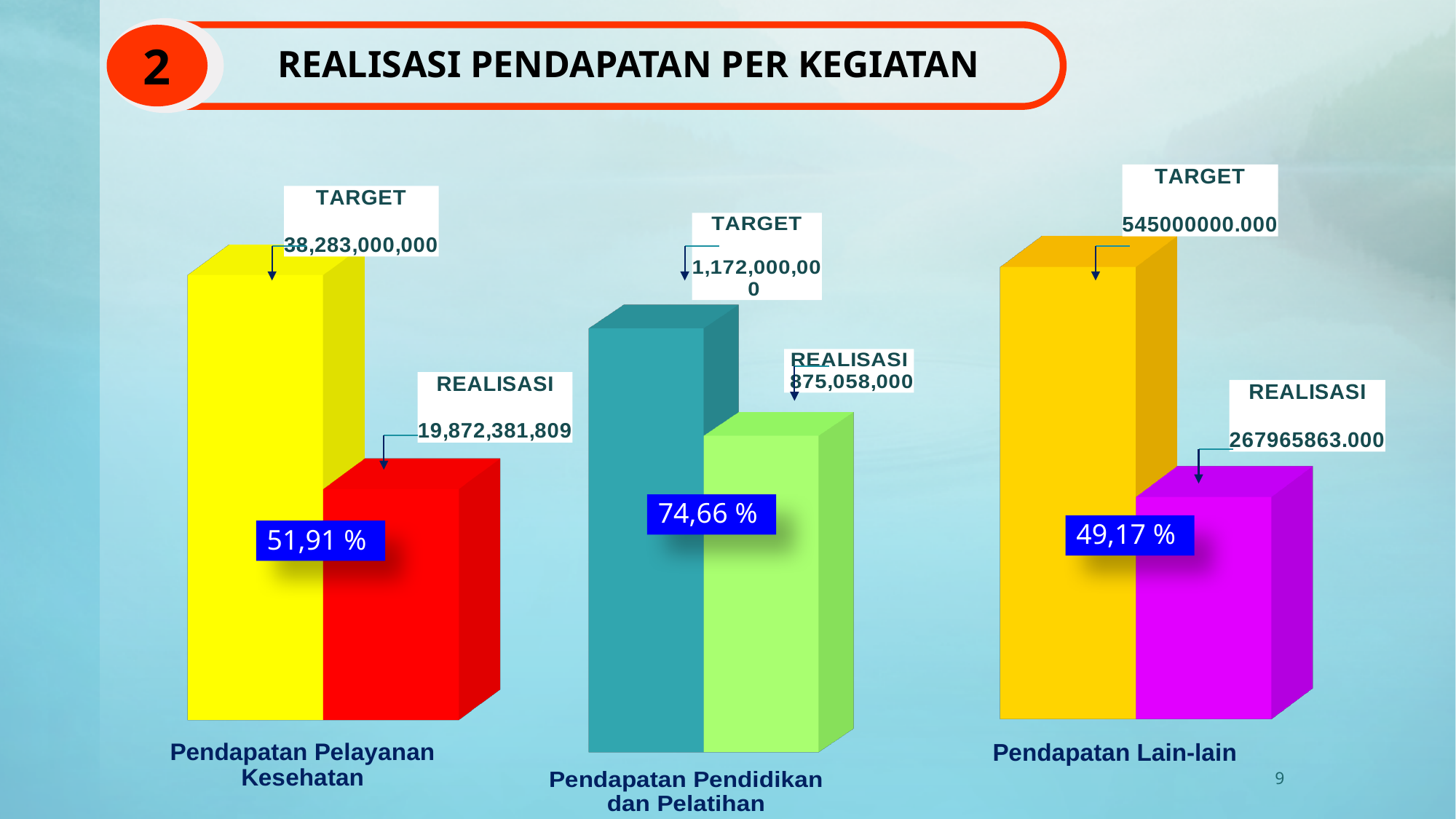
What kind of chart is used for Pendapatan Pelayanan Kesehatan? Bar chart In the Pendapatan Pendidikan dan Pelatihan chart, what is the difference between the TARGET and REALISASI values? 296,942,000 In the Pendapatan Lain-lain chart, which bar is taller, TARGET or REALISASI? TARGET How many bars are in the Pendapatan Pendidikan dan Pelatihan chart? 2 In the Pendapatan Lain-lain chart, what is the REALISASI value? 267965863.000 In the Pendapatan Pendidikan dan Pelatihan chart, what percentage is shown on the blue label? 74,66 % In the Pendapatan Pelayanan Kesehatan chart, what is the TARGET value? 38,283,000,000 In the Pendapatan Lain-lain chart, what percentage is shown on the blue label? 49,17 % In the Pendapatan Pendidikan dan Pelatihan chart, what is the REALISASI value? 875,058,000 In the Pendapatan Pelayanan Kesehatan chart, what is the REALISASI value? 19,872,381,809 In the Pendapatan Pelayanan Kesehatan chart, what is the difference between the TARGET and REALISASI values? 18,410,618,191 In the Pendapatan Pendidikan dan Pelatihan chart, what is the TARGET value? 1,172,000,000